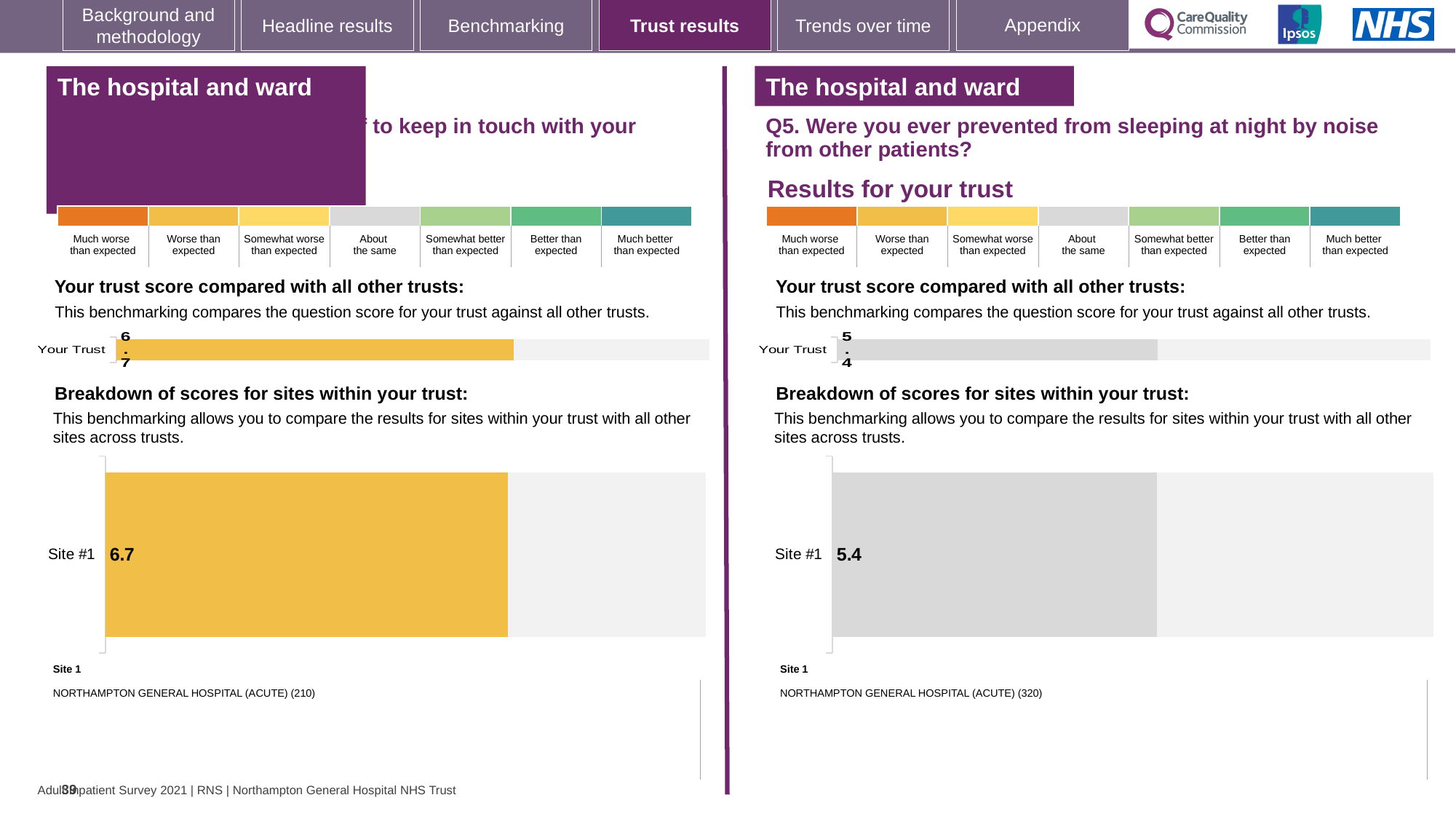
Is the Site #1 score on the right-hand side of the slide (Q5) greater or less than 6? less On the right-hand side of the slide (Q5), what score is shown for Site #1 in the breakdown of scores for sites within your trust? 5.4 How many sites are shown in the breakdown of scores chart on the right-hand side of the slide (Q5)? 1 How many sites are shown in the breakdown of scores chart on the left-hand side of the slide? 1 Which is larger: the Site #1 score on the left-hand side of the slide or the Site #1 score on the right-hand side (Q5)? Left-hand side (6.7) Which site name is listed as Site 1 below the breakdown chart on the right-hand side of the slide (Q5)? NORTHAMPTON GENERAL HOSPITAL (ACUTE) (320) On the left-hand side of the slide, what score is shown for Site #1 in the breakdown of scores for sites within your trust? 6.7 What type of chart is used to show the Site #1 score on the right-hand side of the slide (Q5)? Bar chart Which site name is listed as Site 1 below the breakdown chart on the left-hand side of the slide? NORTHAMPTON GENERAL HOSPITAL (ACUTE) (210) On the right-hand side of the slide (Q5, prevented from sleeping at night by noise), what is the 'Your Trust' score shown in the trust comparison bar chart? 5.4 What is the difference between the Site #1 score on the left-hand side of the slide (6.7) and the Site #1 score on the right-hand side (5.4)? 1.3 On the left-hand side of the slide, what is the 'Your Trust' score shown in the trust comparison bar chart? 6.7